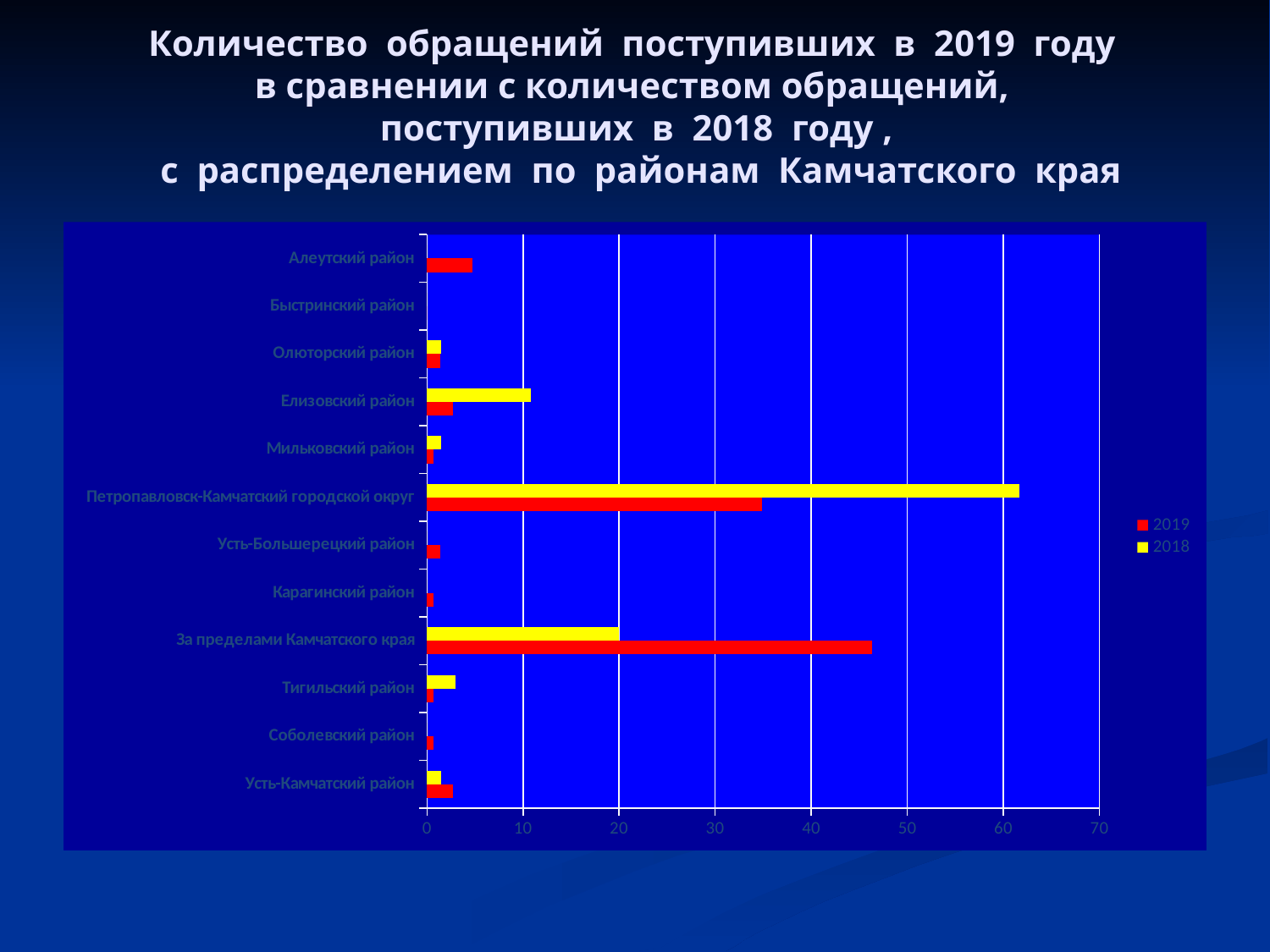
Is the 2018 value for Петропавловск-Камчатский городской округ greater or less than 60? greater Which colour represents the 2018 series in the legend? yellow What kind of chart is shown on the slide? bar chart Is the 2018 value for Елизовский район greater or less than 10? greater How many districts (categories) are shown on the vertical axis? 12 Which category has the highest value for the 2019 series? За пределами Камчатского края For Елизовский район, which series has the larger value, 2019 or 2018? 2018 Is the 2019 value for За пределами Камчатского края greater or less than 40? greater How many series does the legend list? 2 Which category has the highest value for the 2018 series? Петропавловск-Камчатский городской округ For За пределами Камчатского края, which series has the larger value, 2019 or 2018? 2019